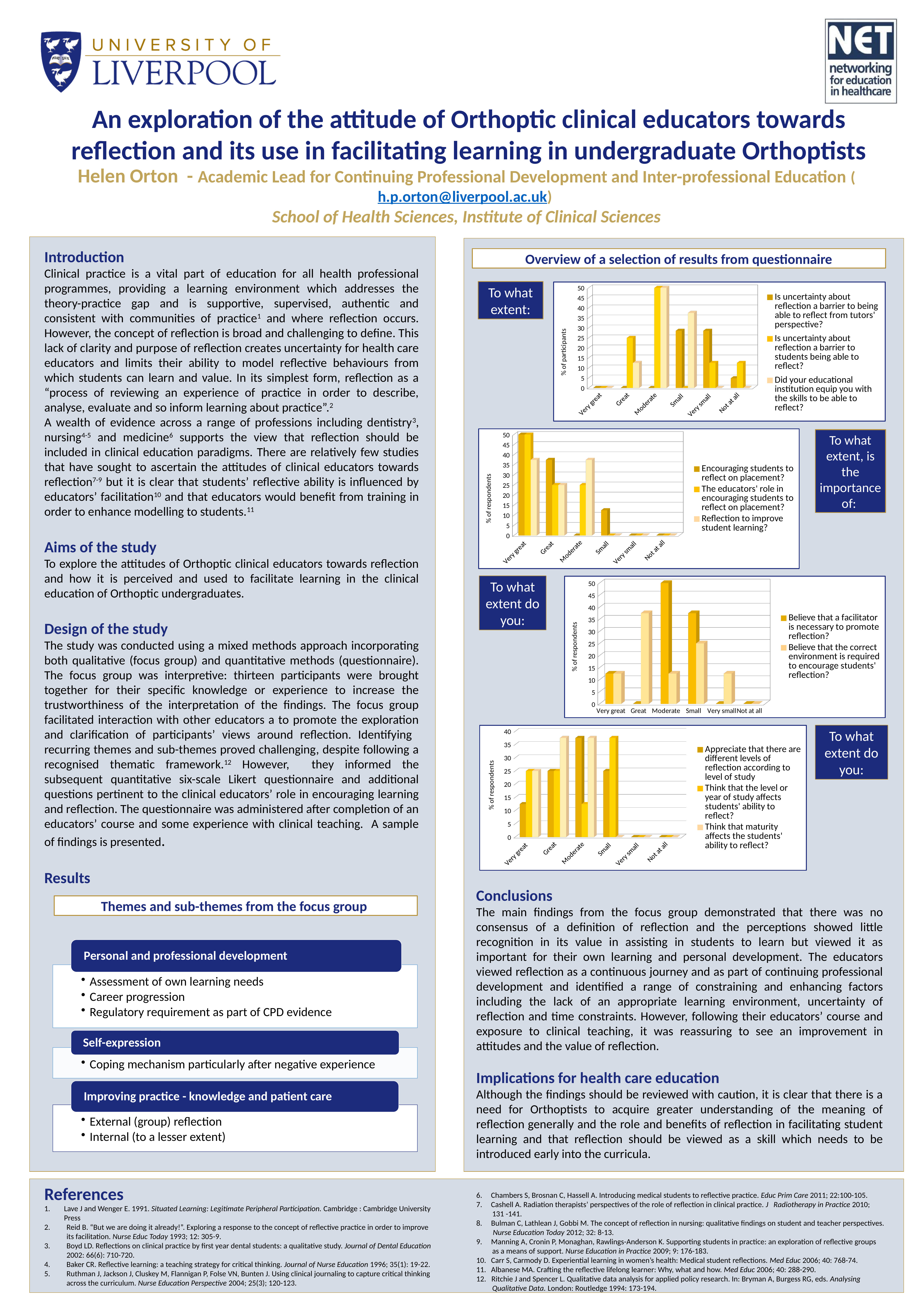
In the top chart on the right (under 'To what extent:'), how many series does the legend list? 3 What kind of chart is the top chart on the right side of the poster (under 'To what extent:')? bar chart In the second chart on the right (next to 'To what extent, is the importance of:'), is the value for 'Very great' in the series 'Encouraging students to reflect on placement?' greater or less than 40? greater In the third chart on the right (next to 'To what extent do you:'), which category has the tallest bar for 'Believe that a facilitator is necessary to promote reflection?'? Moderate In the second chart on the right (next to 'To what extent, is the importance of:'), what is the y-axis label? % of respondents In the bottom chart on the right (next to the lower 'To what extent do you:'), is the value for 'Very great' in the series 'Appreciate that there are different levels of reflection according to level of study' greater or less than 20? less In the second chart on the right (next to 'To what extent, is the importance of:'), which is larger for 'Moderate': 'Encouraging students to reflect on placement?' or 'Reflection to improve student learning?'? Reflection to improve student learning? In the top chart on the right (under 'To what extent:'), how many categories are shown on the x axis? 6 In the third chart on the right (next to 'To what extent do you:'), how many series does the legend list? 2 In the third chart on the right (next to 'To what extent do you:'), is the value for 'Great' in the series 'Believe that the correct environment is required to encourage students' reflection?' greater or less than 30? greater In the top chart on the right (under 'To what extent:'), which category has the tallest bar? Moderate